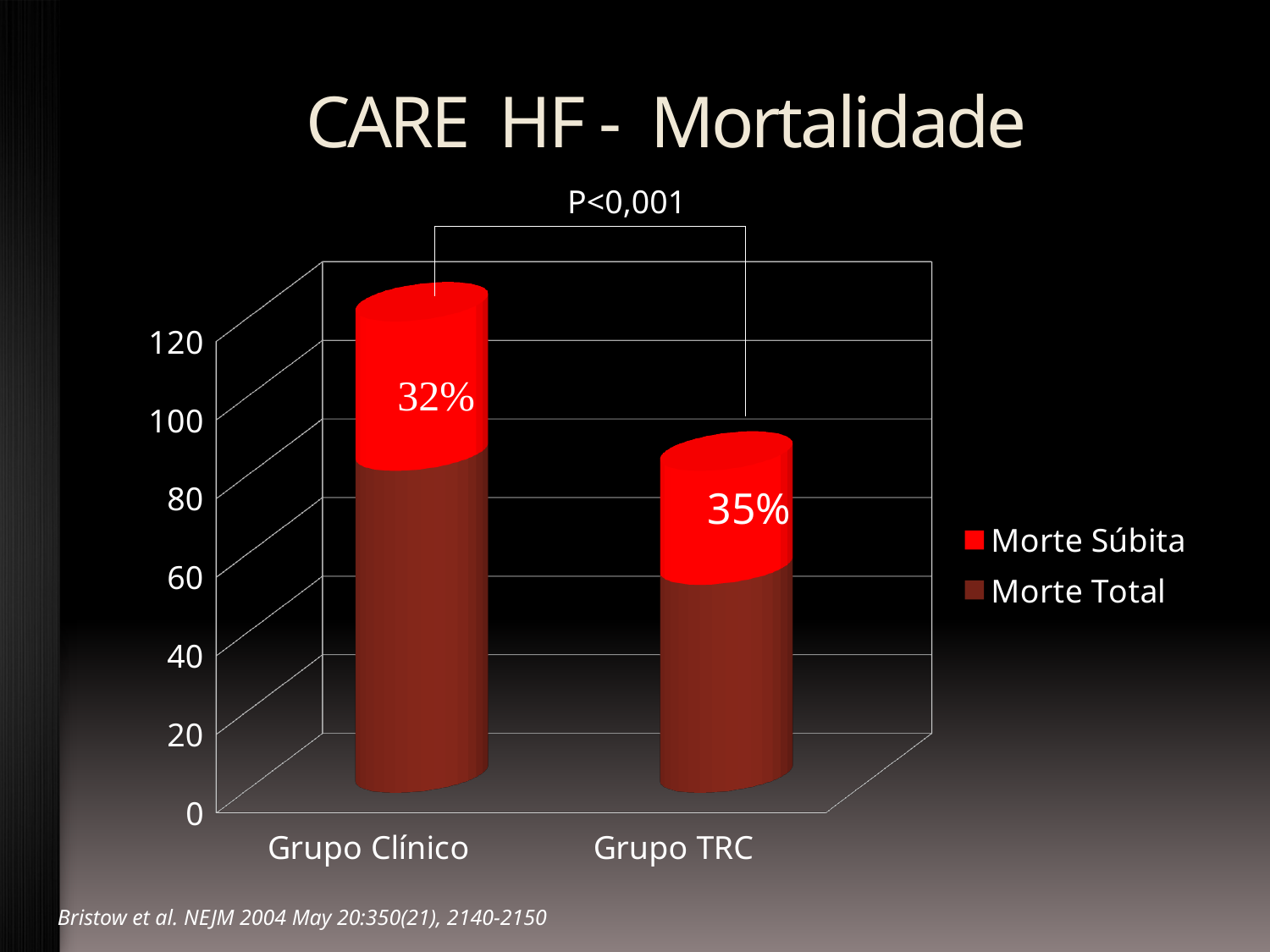
What kind of chart is shown on the slide? bar chart How many series does the chart legend list? 2 What percentage label is shown on the Morte Súbita segment for Grupo Clínico? 32% Which category has the highest total bar? Grupo Clínico Which category has the lowest total bar? Grupo TRC What percentage label is shown on the Morte Súbita segment for Grupo TRC? 35% What P value is shown above the bars on the chart? P<0,001 Is the total bar height for Grupo TRC greater or less than 100? less What is the title of the chart? CARE HF - Mortalidade Which group has the taller stacked bar, Grupo Clínico or Grupo TRC? Grupo Clínico Is the total bar height for Grupo Clínico greater or less than 100? greater How many categories are shown on the x axis of the chart? 2